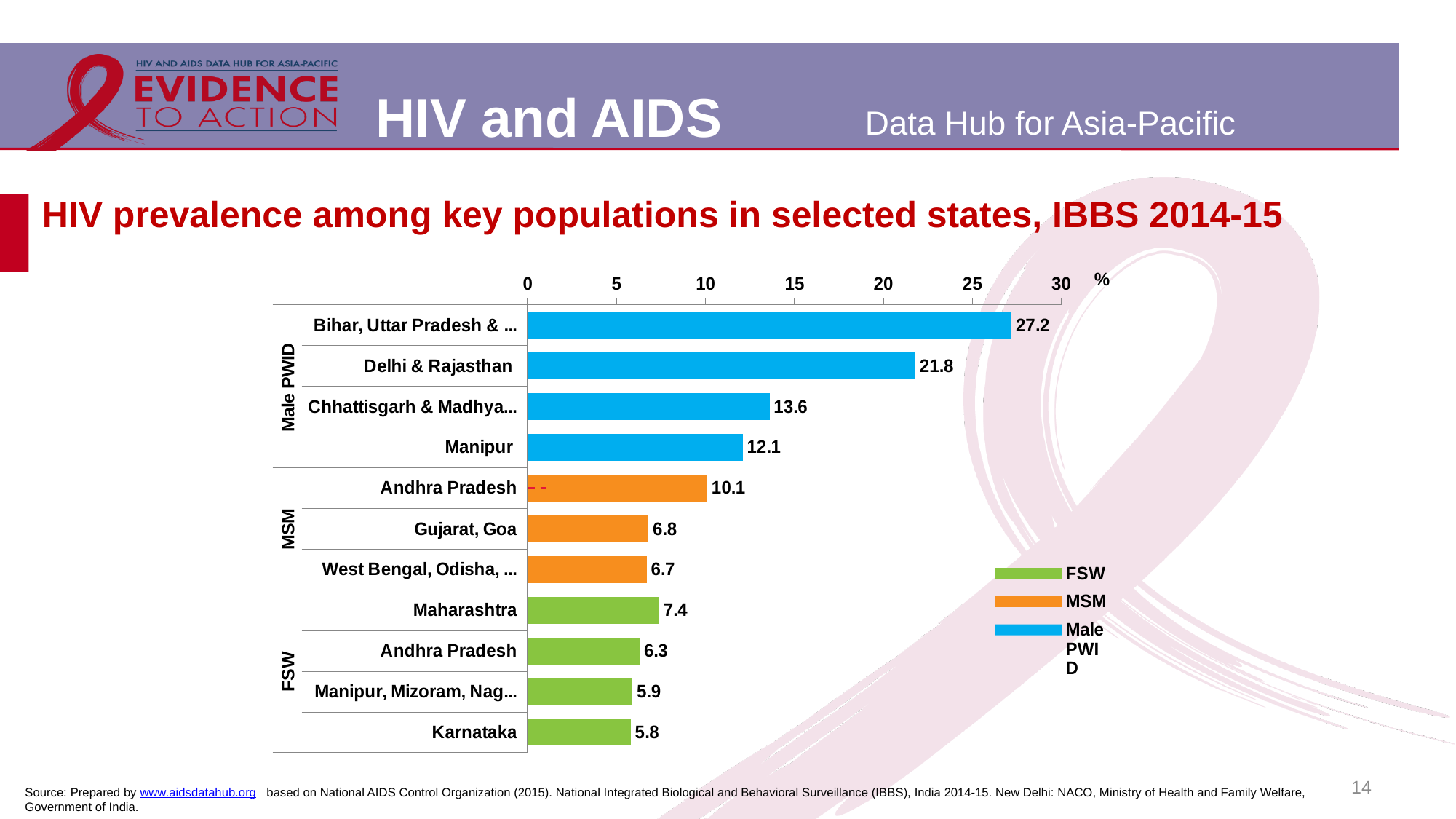
Is the HIV prevalence among Male PWID in Manipur greater or less than 10? greater How many series does the legend list? 3 How many bars are shown on the chart? 11 What kind of chart is shown on the slide? bar chart Which is higher: HIV prevalence among MSM in Andhra Pradesh or among FSW in Andhra Pradesh? MSM in Andhra Pradesh Which category has the lowest HIV prevalence on the chart? Karnataka (FSW) What is the difference between the HIV prevalence among Male PWID in Bihar, Uttar Pradesh & ... and in Delhi & Rajasthan? 5.4 Which category has the highest HIV prevalence on the chart? Bihar, Uttar Pradesh & ... (Male PWID) Which colour represents the FSW series in the chart? green What is the HIV prevalence among Male PWID in Delhi & Rajasthan? 21.8 What is the HIV prevalence among MSM in Gujarat, Goa? 6.8 What is the HIV prevalence among FSW in Karnataka? 5.8